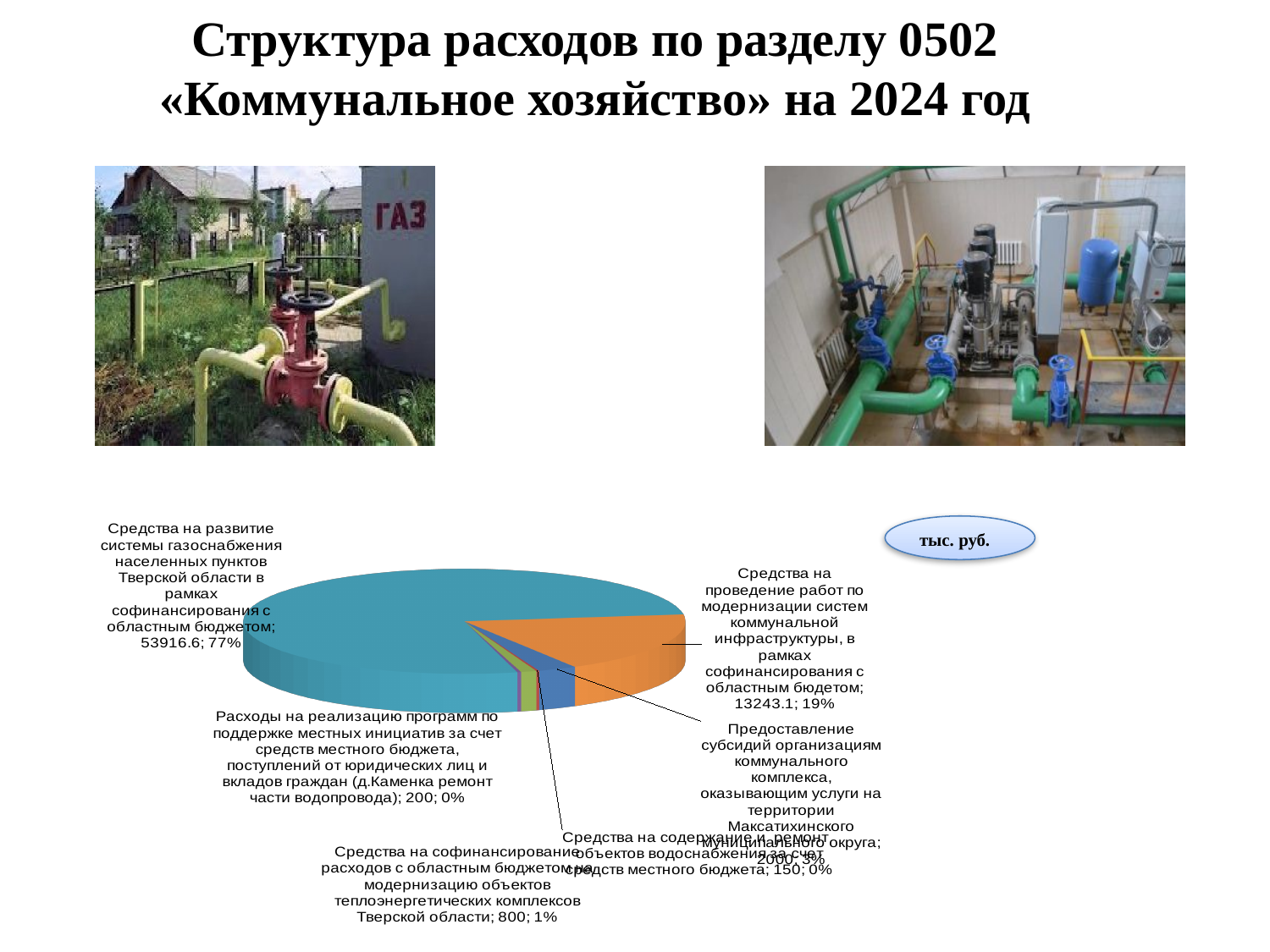
What is the value for 'Средства на софинансирование расходов с областным бюджетом на модернизацию объектов теплоэнергетических комплексов Тверской области'? 800 What share of the pie does 'Средства на проведение работ по модернизации систем коммунальной инфраструктуры' represent? 19% What kind of chart is shown on the slide? pie chart What unit of measurement is indicated next to the chart? тыс. руб. What is the value for 'Средства на развитие системы газоснабжения населенных пунктов Тверской области в рамках софинансирования с областным бюджетом'? 53916.6 Which category has the largest share of the pie chart? Средства на развитие системы газоснабжения населенных пунктов Тверской области в рамках софинансирования с областным бюджетом Which category has the smallest value in the pie chart? Средства на содержание и ремонт объектов водоснабжения за счет средств местного бюджета What is the difference between the value for 'Средства на развитие системы газоснабжения' (53916.6) and 'Средства на проведение работ по модернизации систем коммунальной инфраструктуры' (13243.1)? 40673.5 How many slices does the pie chart have? 6 What is the value for 'Средства на проведение работ по модернизации систем коммунальной инфраструктуры, в рамках софинансирования с областным бюдетом'? 13243.1 Which is larger: the value for 'Расходы на реализацию программ по поддержке местных инициатив' or 'Средства на содержание и ремонт объектов водоснабжения'? Расходы на реализацию программ по поддержке местных инициатив What share of the pie does 'Средства на развитие системы газоснабжения населенных пунктов Тверской области' represent? 77%